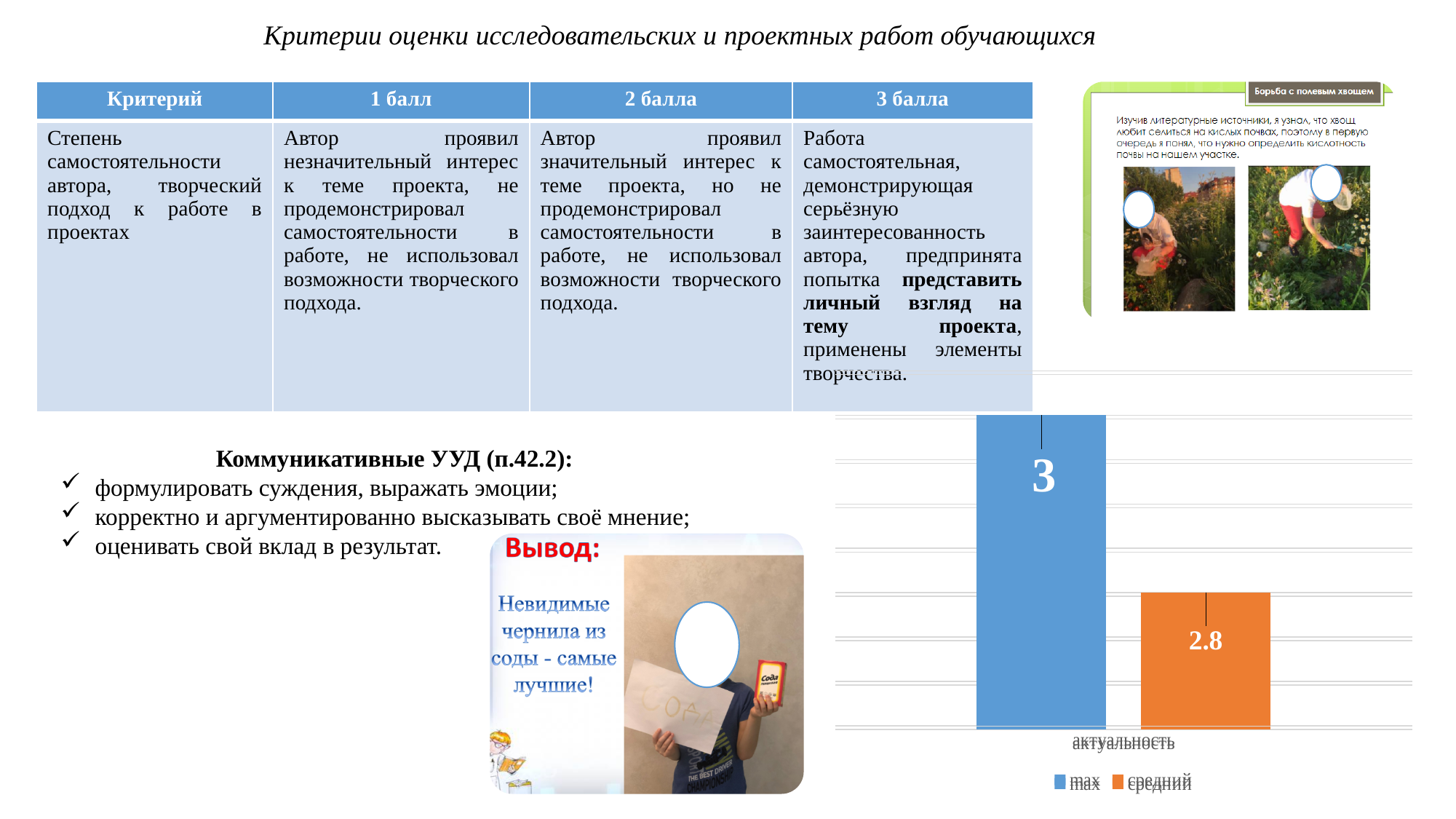
What is the value of the "средний" series for "актуальность"? 2.8 What is the category label shown on the x axis of the chart? актуальность Which series has the higher value for "актуальность", "max" or "средний"? max How many categories are shown on the x axis of the chart? 1 Which series has the lowest value in the chart? средний What is the difference between the "max" and "средний" values for "актуальность"? 0.2 Which colour represents the "средний" series in the chart? orange What is the value of the "max" series for "актуальность"? 3 How many series does the chart legend list? 2 What type of chart is shown on the slide? bar chart